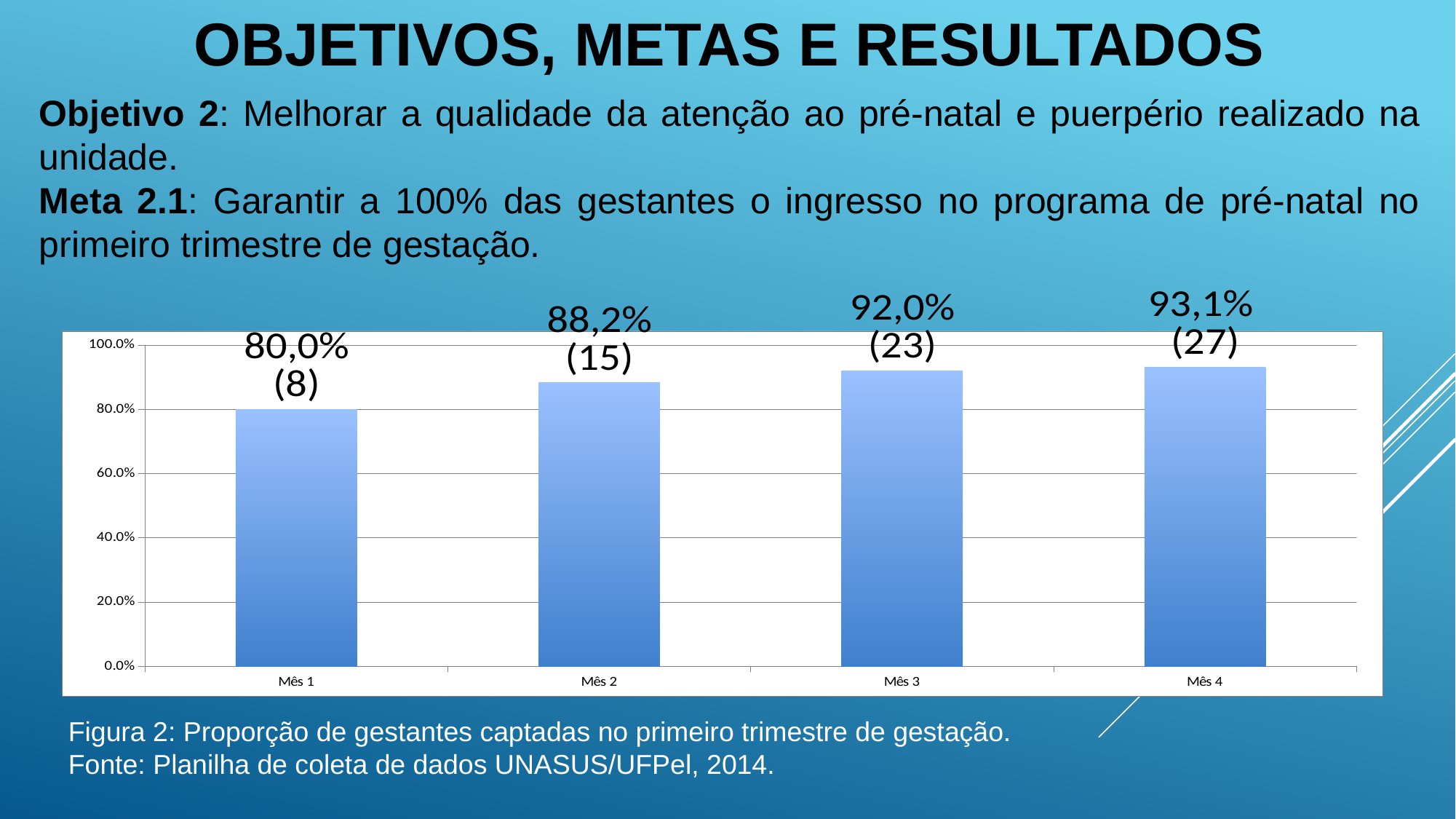
How many pregnant women does the label for Mês 2 show in parentheses? 15 Is the value for Mês 2 greater or less than 80.0%? greater Do the values rise or fall from Mês 1 to Mês 4? rise Which month has the lowest value? Mês 1 Which month has the highest value? Mês 4 How many months are shown on the x axis? 4 What is the value for Mês 3? 92,0% Which is larger, the value for Mês 2 or the value for Mês 3? Mês 3 What is the value for Mês 1? 80,0% What kind of chart is shown? bar chart What is the difference between the values for Mês 2 and Mês 1? 8,2% What is the value for Mês 4? 93,1%